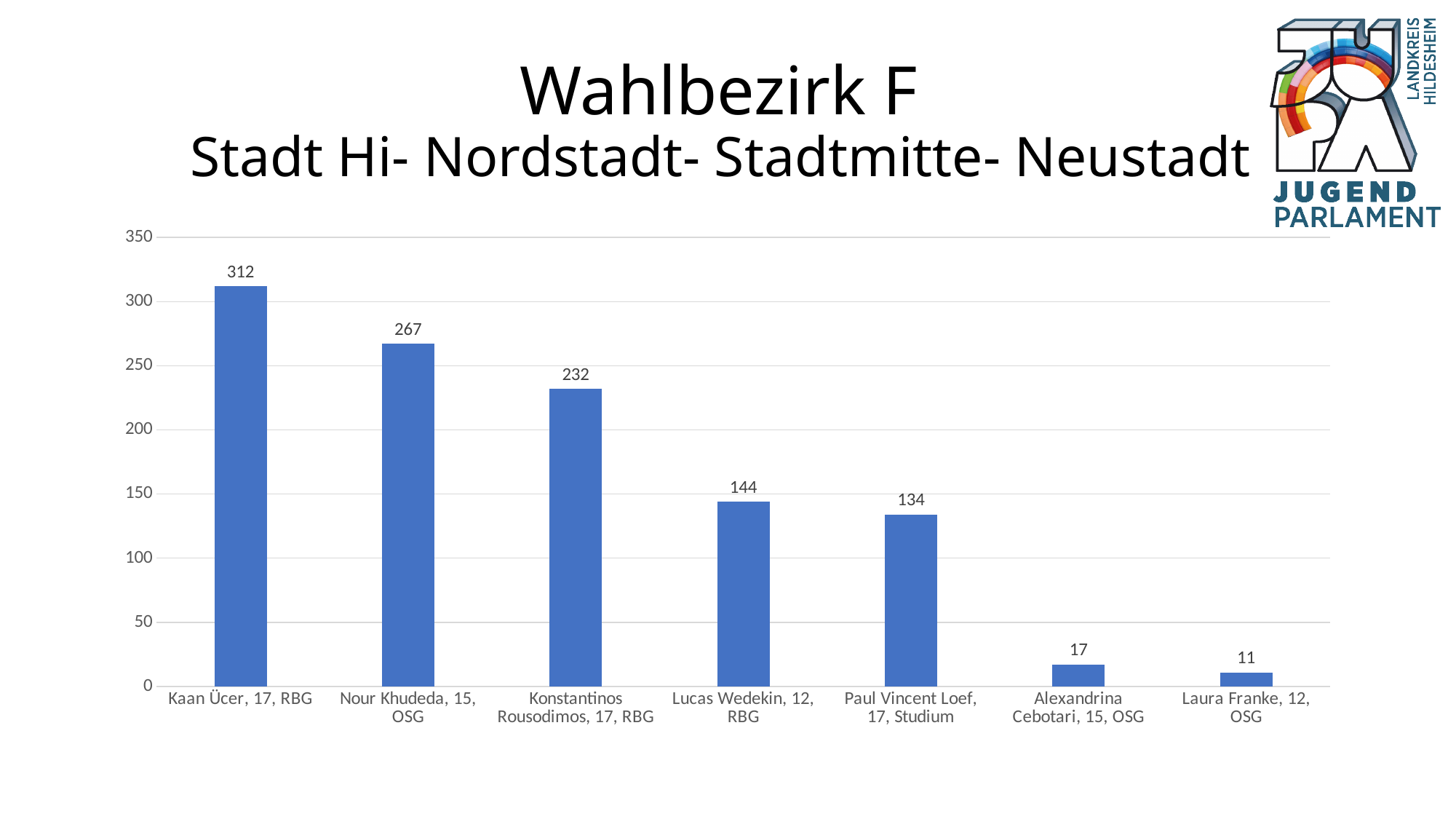
What is the value shown for Nour Khudeda? 267 How many candidates are shown in the chart? 7 What is the value shown for Paul Vincent Loef? 134 How many votes did Kaan Ücer receive? 312 What is the difference between the values for Lucas Wedekin and Paul Vincent Loef? 10 Who has the larger value, Konstantinos Rousodimos or Lucas Wedekin? Konstantinos Rousodimos Which candidate has the highest value? Kaan Ücer Which candidate has the lowest value? Laura Franke What is the difference between the values for Kaan Ücer and Nour Khudeda? 45 Is the value for Alexandrina Cebotari greater or less than 50? less What is the value shown for Laura Franke? 11 What kind of chart is shown on the slide? Bar chart